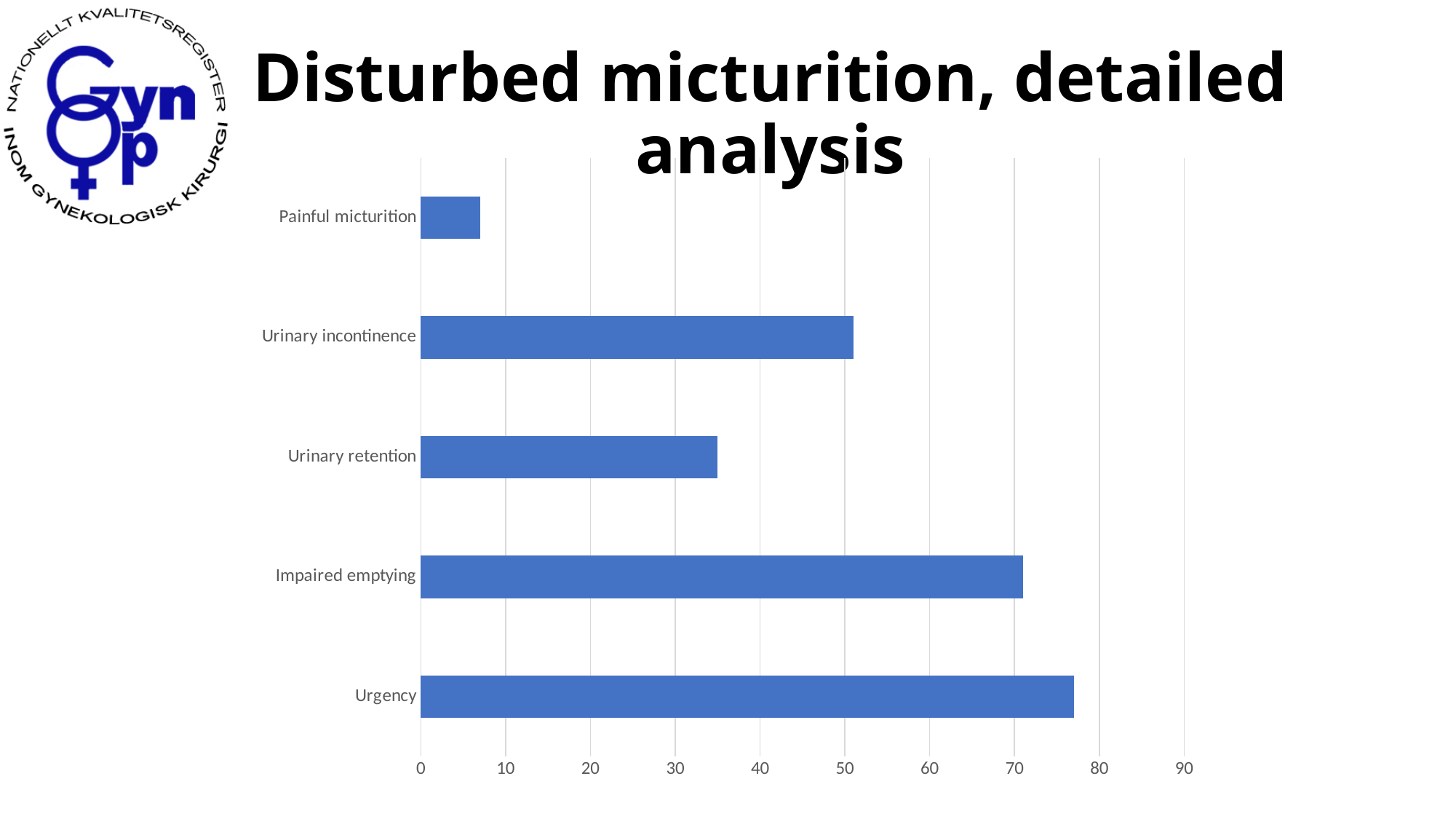
Which is larger, the value for Impaired emptying or the value for Urinary incontinence? Impaired emptying How many categories are plotted in the chart? 5 What is the title of the slide? Disturbed micturition, detailed analysis Which category has the highest value? Urgency Which is larger, the value for Urinary incontinence or the value for Urinary retention? Urinary incontinence What kind of chart is shown on the slide? bar chart Which category has the lowest value? Painful micturition Is the value for Urgency greater or less than 80? less Is the value for Painful micturition greater or less than 10? less Is the value for Urinary retention greater or less than 40? less